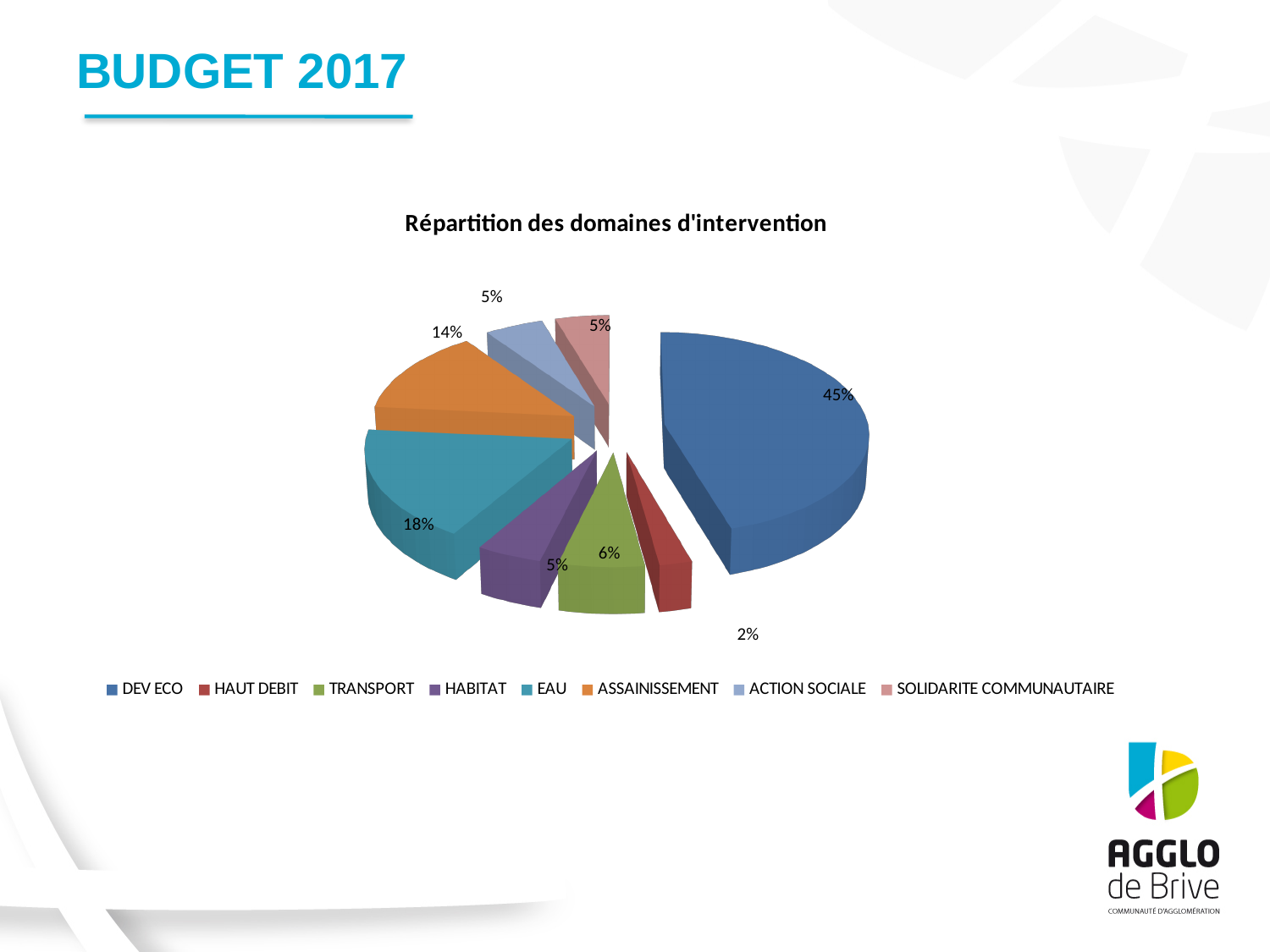
What share of the pie does TRANSPORT represent? 6% What share of the pie does EAU represent? 18% What share of the pie does DEV ECO represent? 45% Which category has the largest share of the pie? DEV ECO Which category has the smallest share of the pie? HAUT DEBIT Which has a larger share, TRANSPORT or HABITAT? TRANSPORT How many categories does the legend list? 8 What is the title of the chart? Répartition des domaines d'intervention What is the difference between the shares of EAU and ASSAINISSEMENT? 4% What kind of chart is shown on the slide? pie chart